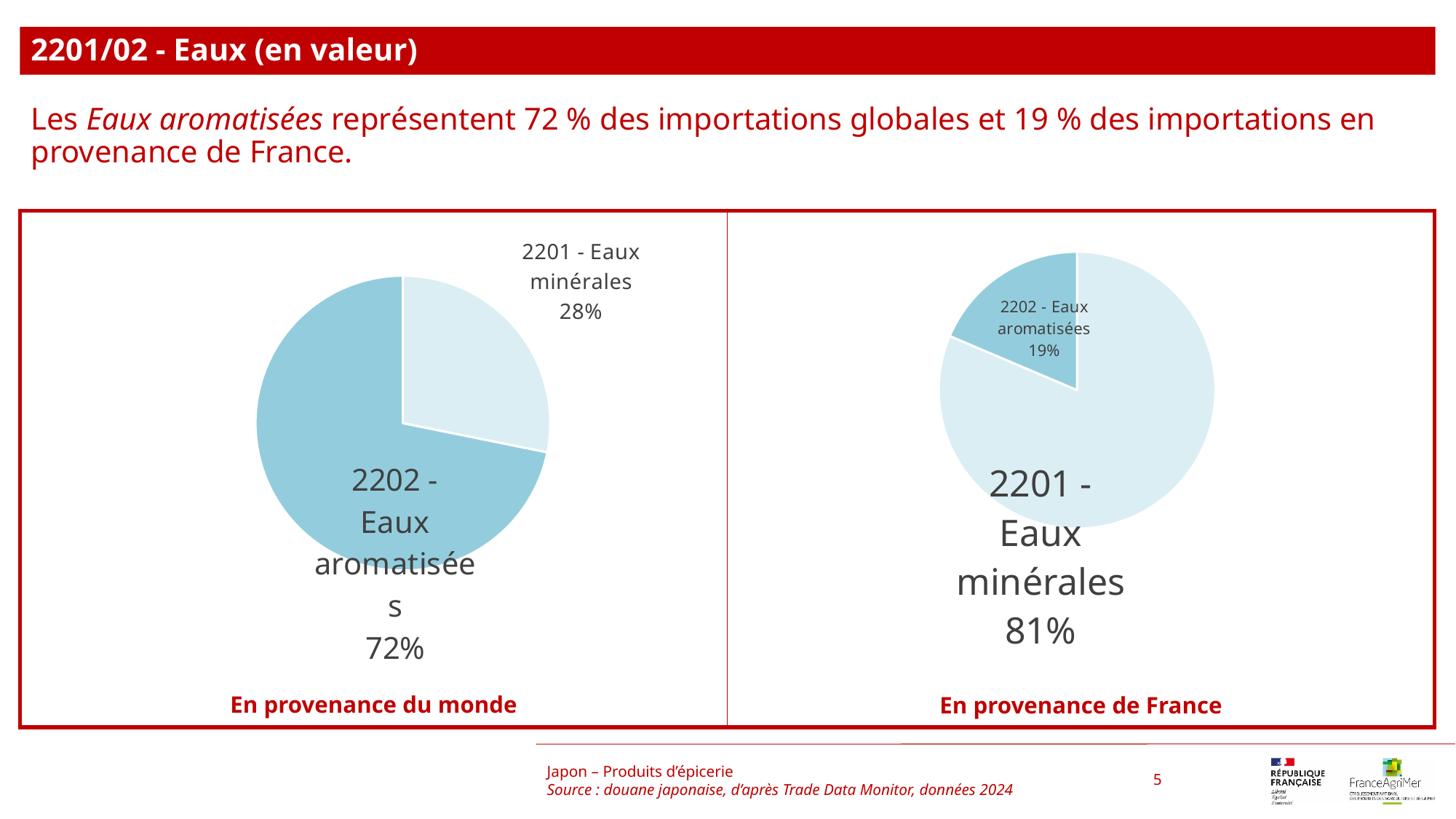
In the 'En provenance du monde' pie chart, what is the difference in percentage points between the 2202 - Eaux aromatisées share and the 2201 - Eaux minérales share? 44 percentage points In the 'En provenance de France' pie chart, what is the difference in percentage points between the 2201 - Eaux minérales share and the 2202 - Eaux aromatisées share? 62 percentage points In the 'En provenance du monde' pie chart, what share do 2202 - Eaux aromatisées represent? 72% In the 'En provenance de France' pie chart, which category has the smallest share? 2202 - Eaux aromatisées In the 'En provenance de France' pie chart, what share do 2202 - Eaux aromatisées represent? 19% What type of chart is used on the left side of the slide ('En provenance du monde')? Pie chart How many categories does the 'En provenance de France' pie chart show? 2 In the 'En provenance de France' pie chart, what share do 2201 - Eaux minérales represent? 81% Is the share of 2202 - Eaux aromatisées larger in the 'En provenance du monde' chart or in the 'En provenance de France' chart? En provenance du monde What is the title of the slide? 2201/02 - Eaux (en valeur) In the 'En provenance du monde' pie chart, which category has the largest share? 2202 - Eaux aromatisées